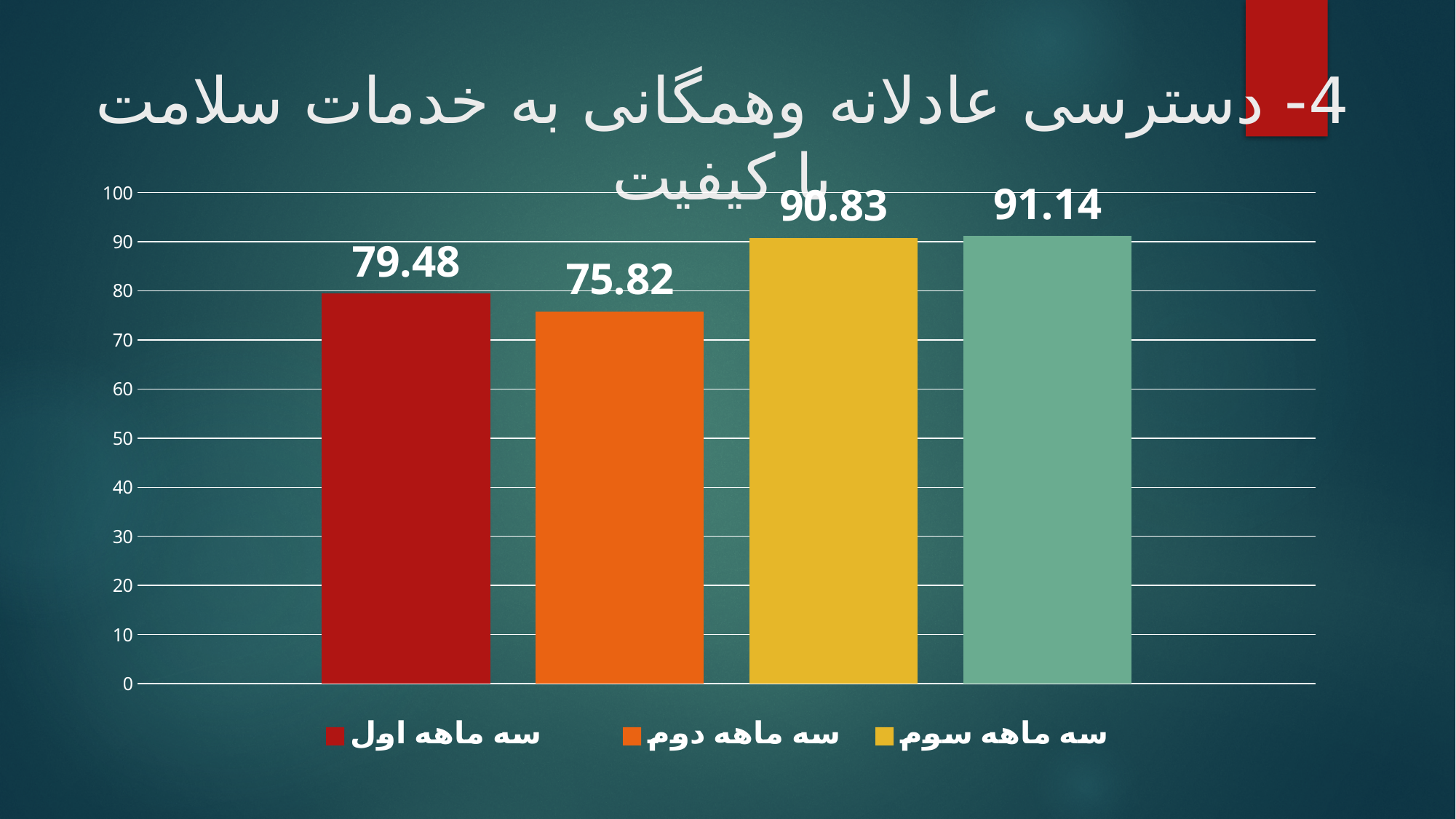
What is the value shown for سه ماهه دوم? 75.82 What is the value shown for سه ماهه اول? 79.48 What is the value labelled on the fourth (teal) bar? 91.14 Which category has the lowest value? سه ماهه دوم Is the value for سه ماهه دوم greater or less than 80? less Which is larger, the value for سه ماهه اول or سه ماهه دوم? سه ماهه اول What is the value shown for سه ماهه سوم? 90.83 How much higher is سه ماهه سوم than سه ماهه اول? 11.35 Which bar has the highest value? The fourth (teal) bar, 91.14 How many entries does the legend list? 3 How many bars are plotted in the chart? 4 What is the difference between the values for سه ماهه اول and سه ماهه دوم? 3.66